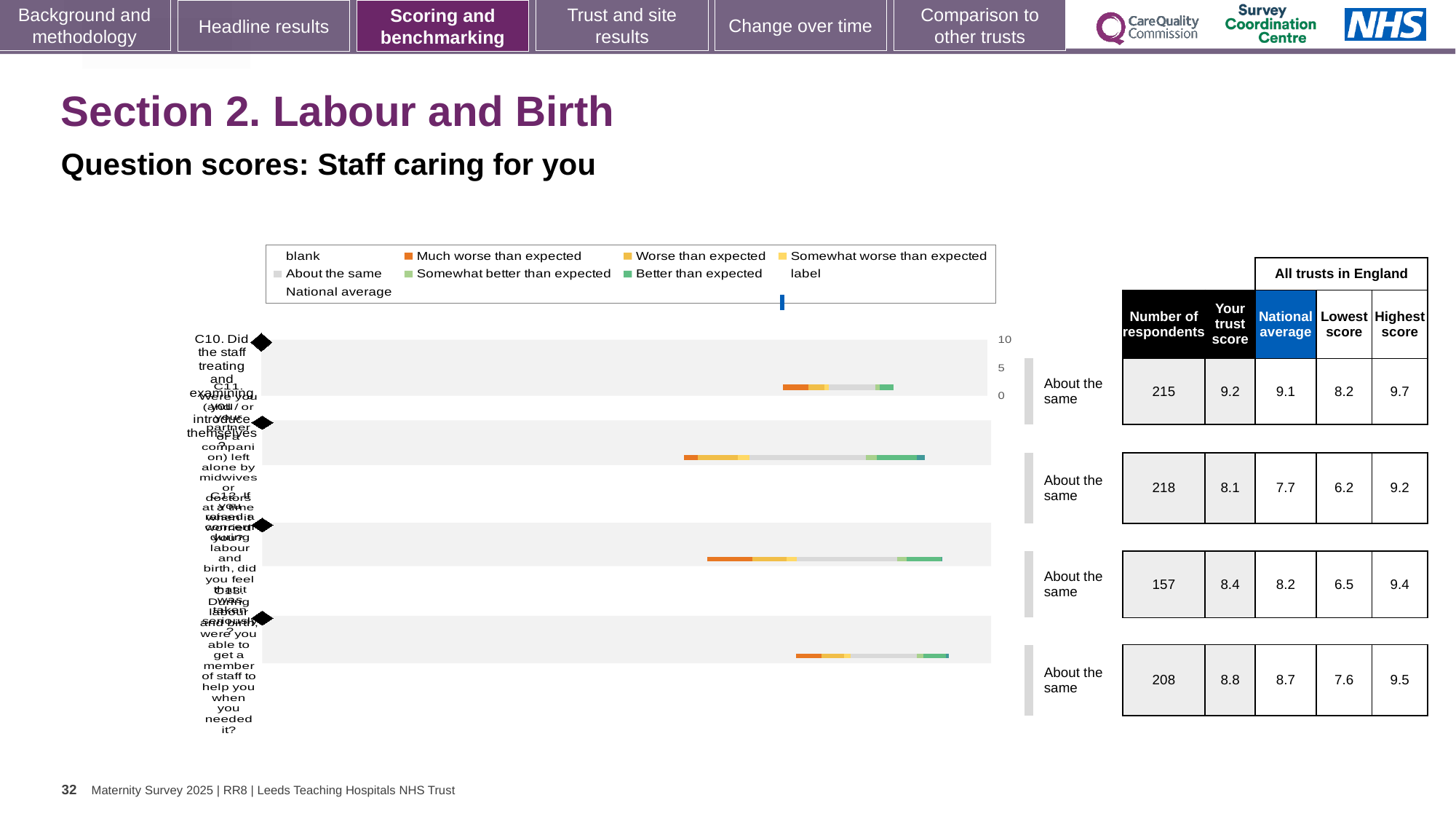
In the table, what is the highest score for the fourth row (C13)? 9.5 What kind of chart is shown on the slide? bar chart What is the difference between the trust score and the national average for the second row (C11)? 0.4 What benchmark category is shown next to each of the four bars? About the same How many question rows (bars) does the chart show? 4 What colour does the legend use for 'Much worse than expected'? orange In the table, what is the trust score for the second row (C11)? 8.1 Which row has the lowest number of respondents in the table? C12 (157) In the table, what is the national average for the third row (C12)? 8.2 In the table, what is the number of respondents for the first row (C10)? 215 Which row has the highest trust score in the table? C10 (9.2) Is the trust score for the first row (C10) larger or smaller than its national average? larger